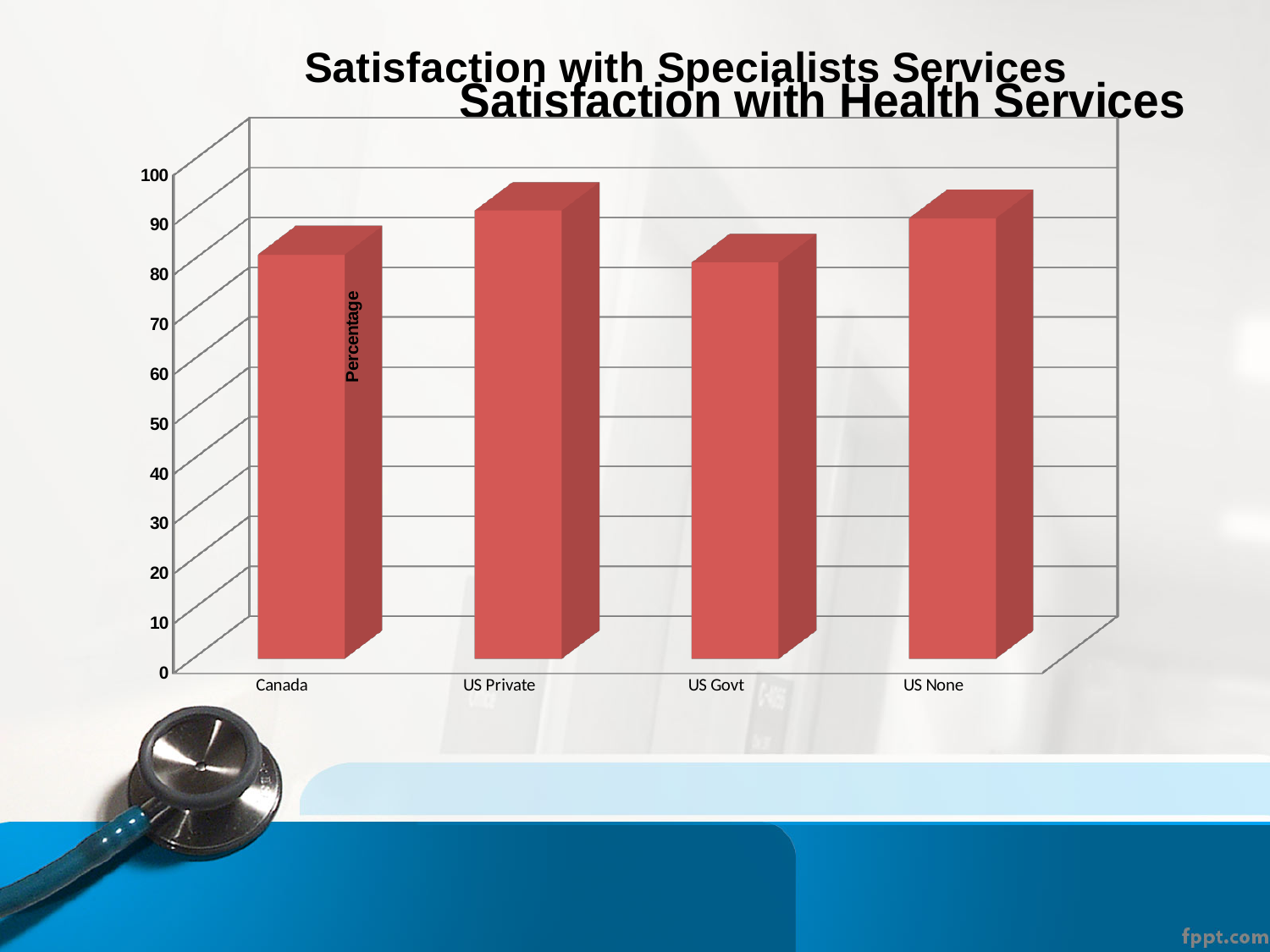
What is the label on the vertical axis of the chart? Percentage Is the value for US Private greater or less than 80? greater How many categories are plotted on the chart? 4 Is the value for US Govt greater or less than 70? greater What kind of chart is shown on the slide? bar chart What is the label of the first category on the x axis? Canada Is the value for US Govt greater or less than 90? less Which is larger, the value for US None or the value for Canada? US None Which is larger, the value for US Private or the value for US Govt? US Private